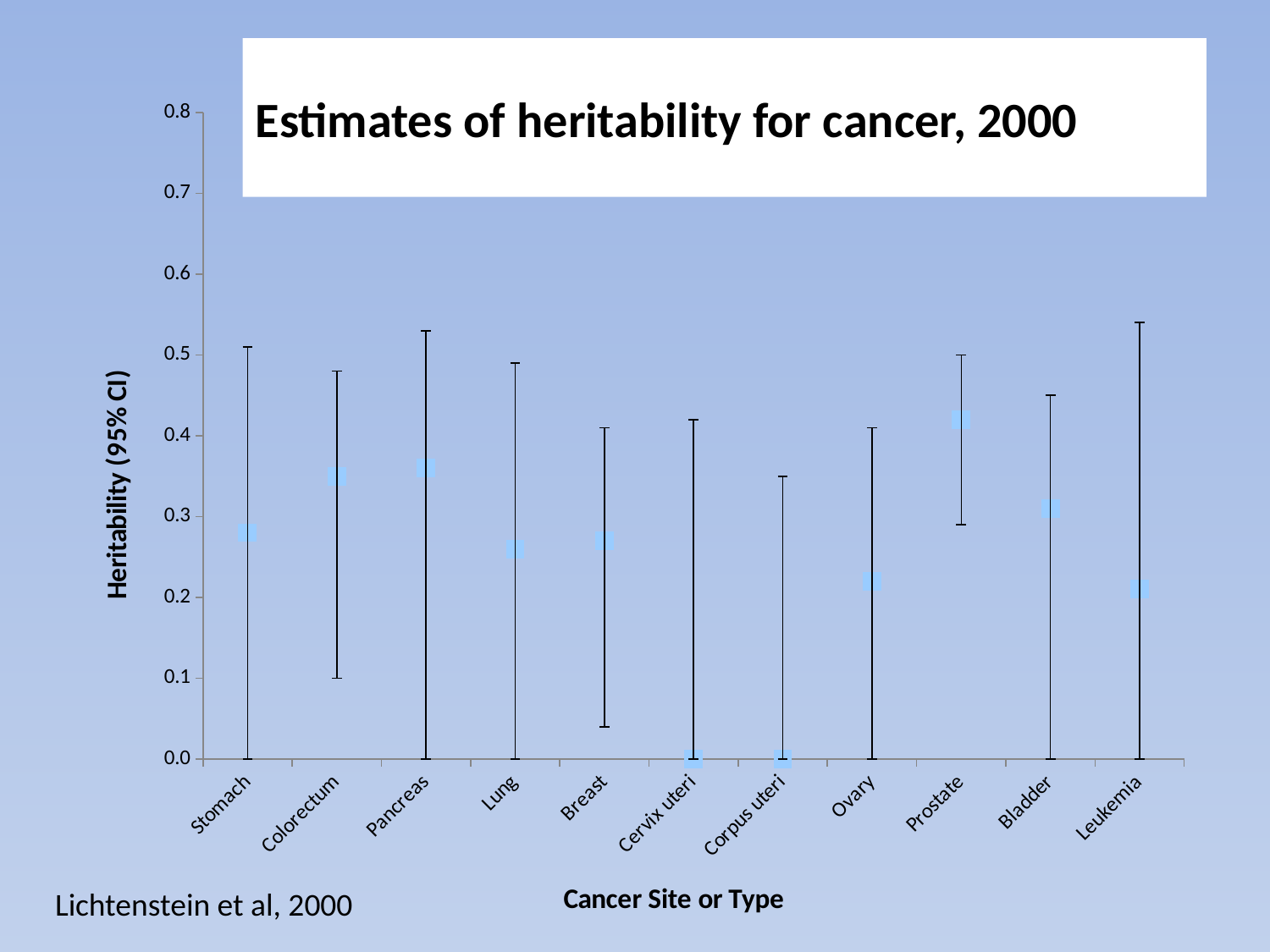
What is the heritability estimate plotted for Corpus uteri? 0.0 Which has a higher heritability estimate, Bladder or Ovary? Bladder What is the heritability estimate plotted for Cervix uteri? 0.0 Is the heritability estimate for Colorectum greater or less than 0.3? greater What kind of chart is this? Scatter (point) chart with error bars What is the label of the y axis? Heritability (95% CI) Which has a higher heritability estimate, Prostate or Stomach? Prostate Which cancer site has the highest heritability estimate? Prostate Is the heritability estimate for Stomach greater or less than 0.3? less Is the heritability estimate for Prostate greater or less than 0.4? greater What is the title of the chart? Estimates of heritability for cancer, 2000 How many cancer sites or types are plotted on the x axis? 11